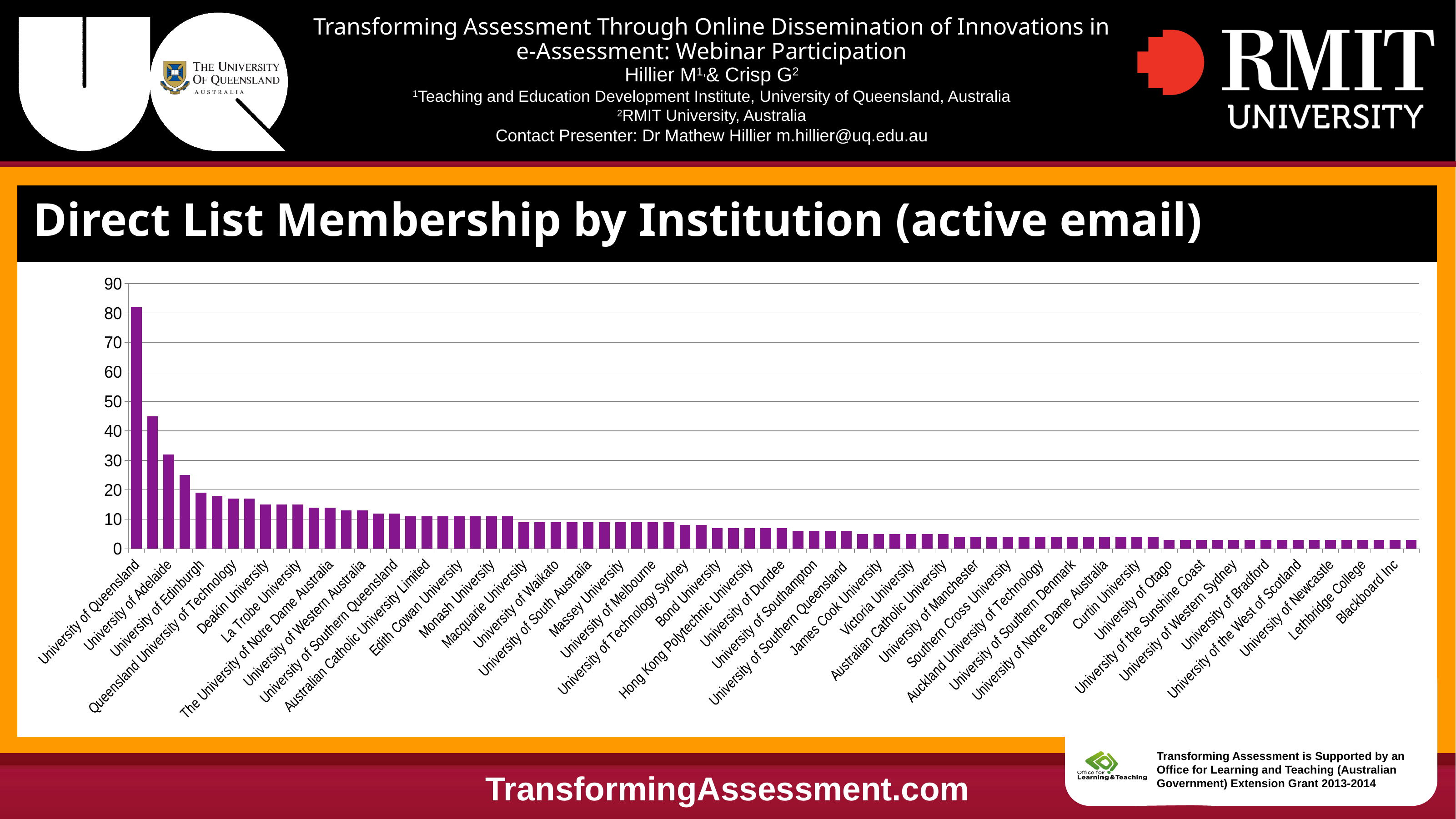
Is the value for University of Queensland greater or less than 70? greater What kind of chart is shown on the slide? bar chart Do the values rise or fall moving from left to right along the x axis? fall Which has a larger value, University of Queensland or University of Adelaide? University of Queensland Which has a larger value, University of Edinburgh or Monash University? University of Edinburgh What is the title of the chart? Direct List Membership by Institution (active email) Is the value for Deakin University greater or less than 30? less Is the value for Queensland University of Technology greater or less than 20? less Which institution has the highest direct list membership? University of Queensland